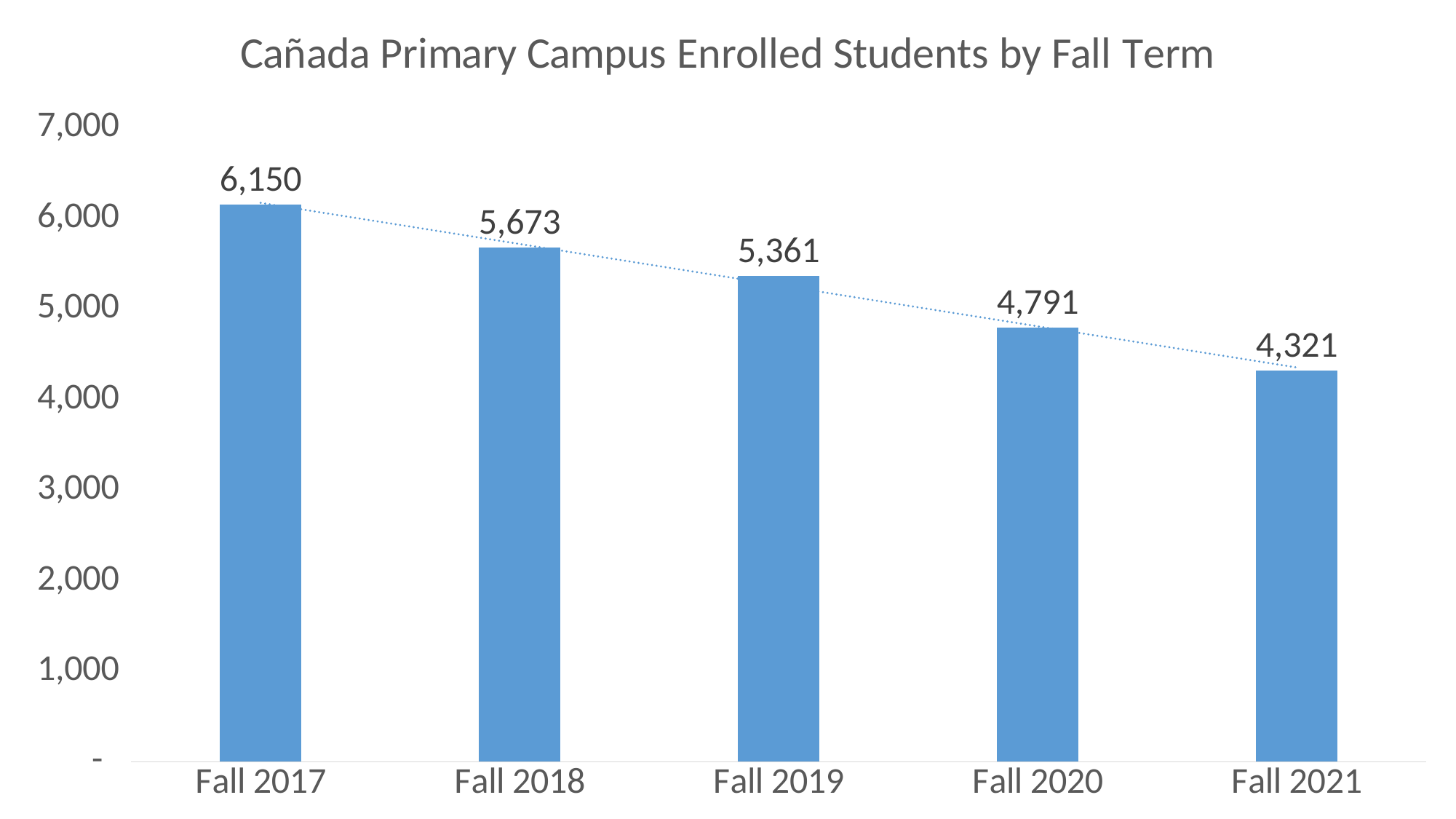
Which term had more enrolled students, Fall 2018 or Fall 2020? Fall 2018 What is the difference in enrolled students between Fall 2017 and Fall 2021? 1,829 What type of chart is shown on the slide? bar chart How many students were enrolled at Cañada primary campus in Fall 2017? 6,150 Is the enrollment for Fall 2020 greater or less than 5,000? less What is the enrolled student count for Fall 2019? 5,361 How many fall terms are shown in the chart? 5 What is the enrolled student count for Fall 2021? 4,321 Do enrolled student numbers rise or fall from Fall 2017 to Fall 2021? fall Which fall term has the highest enrollment? Fall 2017 What is the difference in enrolled students between Fall 2018 and Fall 2019? 312 Which fall term has the lowest enrollment? Fall 2021